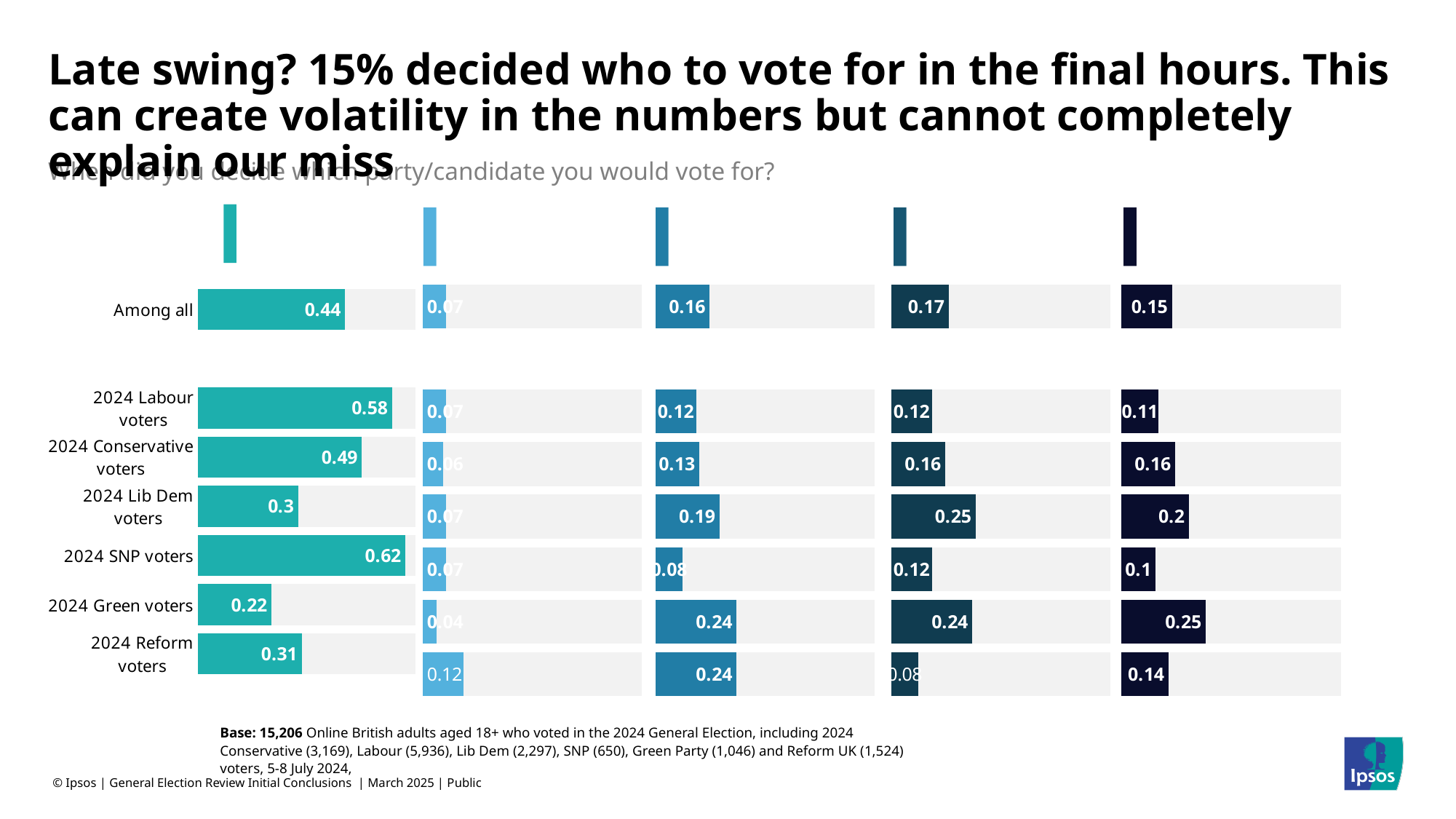
How many colour-coded series (groups of bars) does the chart show? 5 In the leftmost (teal) group of bars, which voter group has the highest value? 2024 SNP voters In the rightmost (dark navy) group of bars, what is the value for 2024 Green voters? 0.25 In the leftmost (teal) group of bars, what is the value for Among all? 0.44 In the leftmost (teal) group of bars, what is the difference between 2024 Labour voters and 2024 Conservative voters? 0.09 In the leftmost (teal) group of bars, which voter group has the lowest value? 2024 Green voters In the leftmost (teal) group of bars, what is the value for 2024 SNP voters? 0.62 What kind of chart is shown on the slide? Bar chart In the fourth group of bars from the left, what is the value for 2024 Lib Dem voters? 0.25 In the rightmost (dark navy) group of bars, which is larger: 2024 Lib Dem voters or 2024 Reform voters? 2024 Lib Dem voters How many voter groups (rows), including Among all, are shown in the chart? 7 In the rightmost (dark navy) group of bars, what is the value for Among all? 0.15